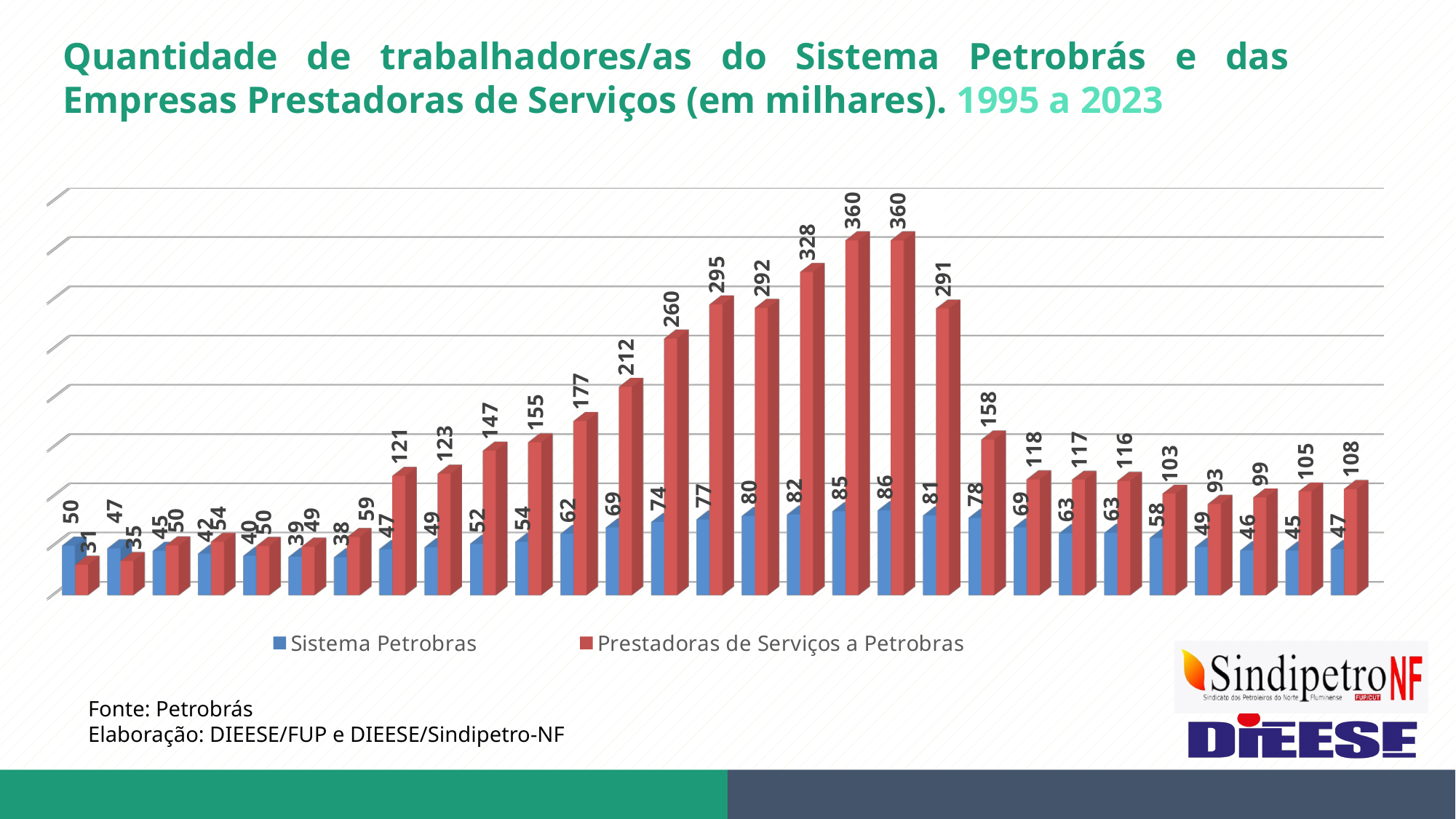
What is the lowest value shown for the Sistema Petrobras series? 38 What is the lowest value shown for the Prestadoras de Serviços a Petrobras series? 31 What is the highest value shown for the Prestadoras de Serviços a Petrobras series? 360 For the last (rightmost) pair of bars, what is the difference between the Prestadoras de Serviços a Petrobras value and the Sistema Petrobras value? 61 How many series does the legend list? 2 What are the two series named in the legend? Sistema Petrobras; Prestadoras de Serviços a Petrobras What is the value of the first (leftmost) Sistema Petrobras bar? 50 What kind of chart is shown on the slide? Bar chart For the first (leftmost) pair of bars, which series has the larger value? Sistema Petrobras How many pairs of bars (categories) are plotted in the chart? 29 What is the value of the last (rightmost) Prestadoras de Serviços a Petrobras bar? 108 What is the highest value shown for the Sistema Petrobras series? 86